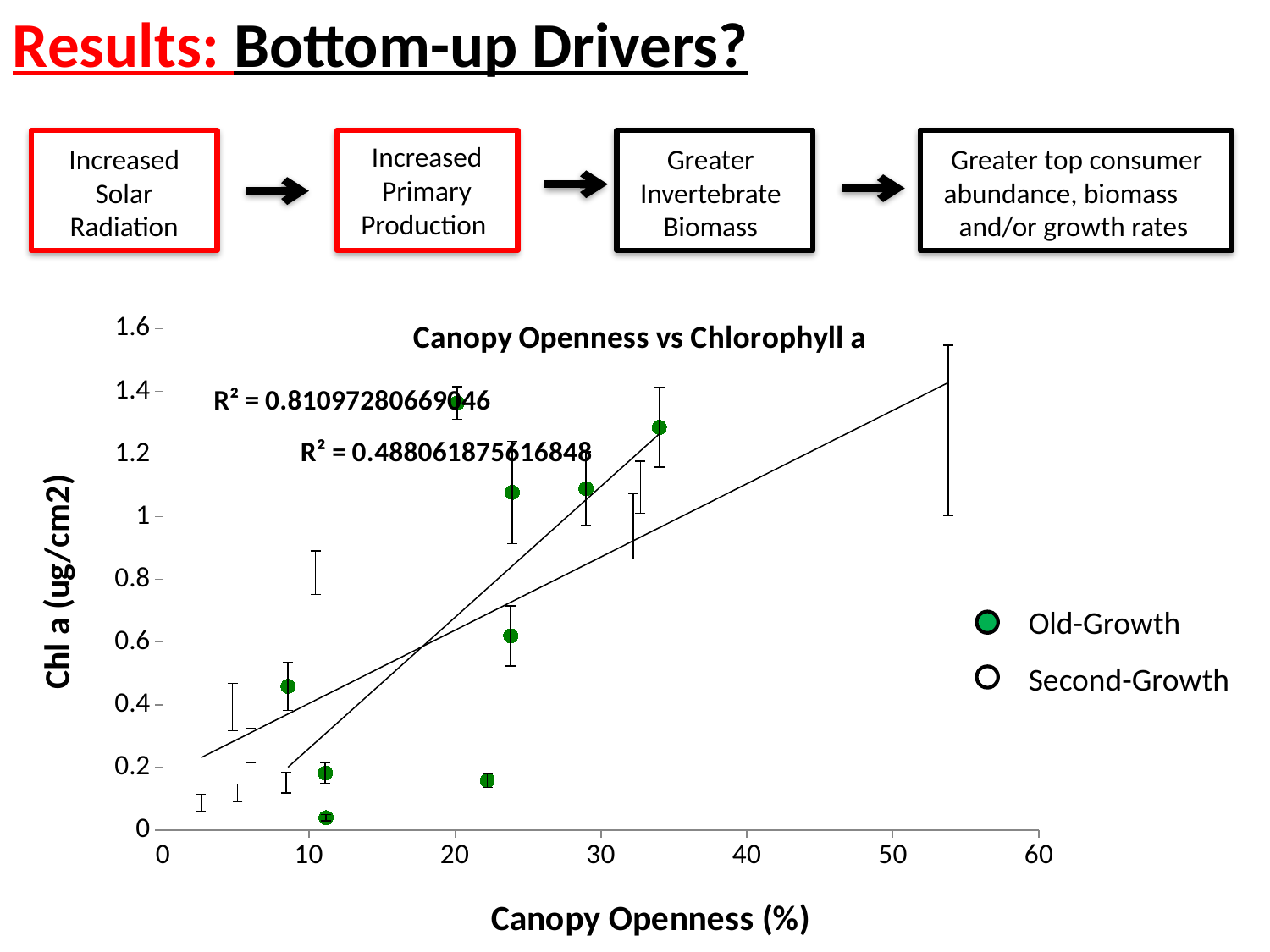
What is the label of the y axis of the chart? Chl a (ug/cm2) Which of the two R² values printed on the chart is larger, the upper one or the lower one? the upper one How many series does the chart legend list? 2 What is the highest value shown on the y axis of the chart? 1.6 Does Chl a generally rise or fall as Canopy Openness increases along the x axis? rise Is the Chl a value for the Old-Growth point at about 8% canopy openness greater or less than 0.4? greater What is the label of the x axis of the chart? Canopy Openness (%) Is the Chl a value for the Old-Growth point at about 34% canopy openness greater or less than 1.2? greater Is the Chl a value for the lowest Old-Growth point near 11% canopy openness greater or less than 0.2? less What are the two series named in the chart legend? Old-Growth and Second-Growth What kind of chart is shown on the slide? scatter chart What is the title of the chart? Canopy Openness vs Chlorophyll a